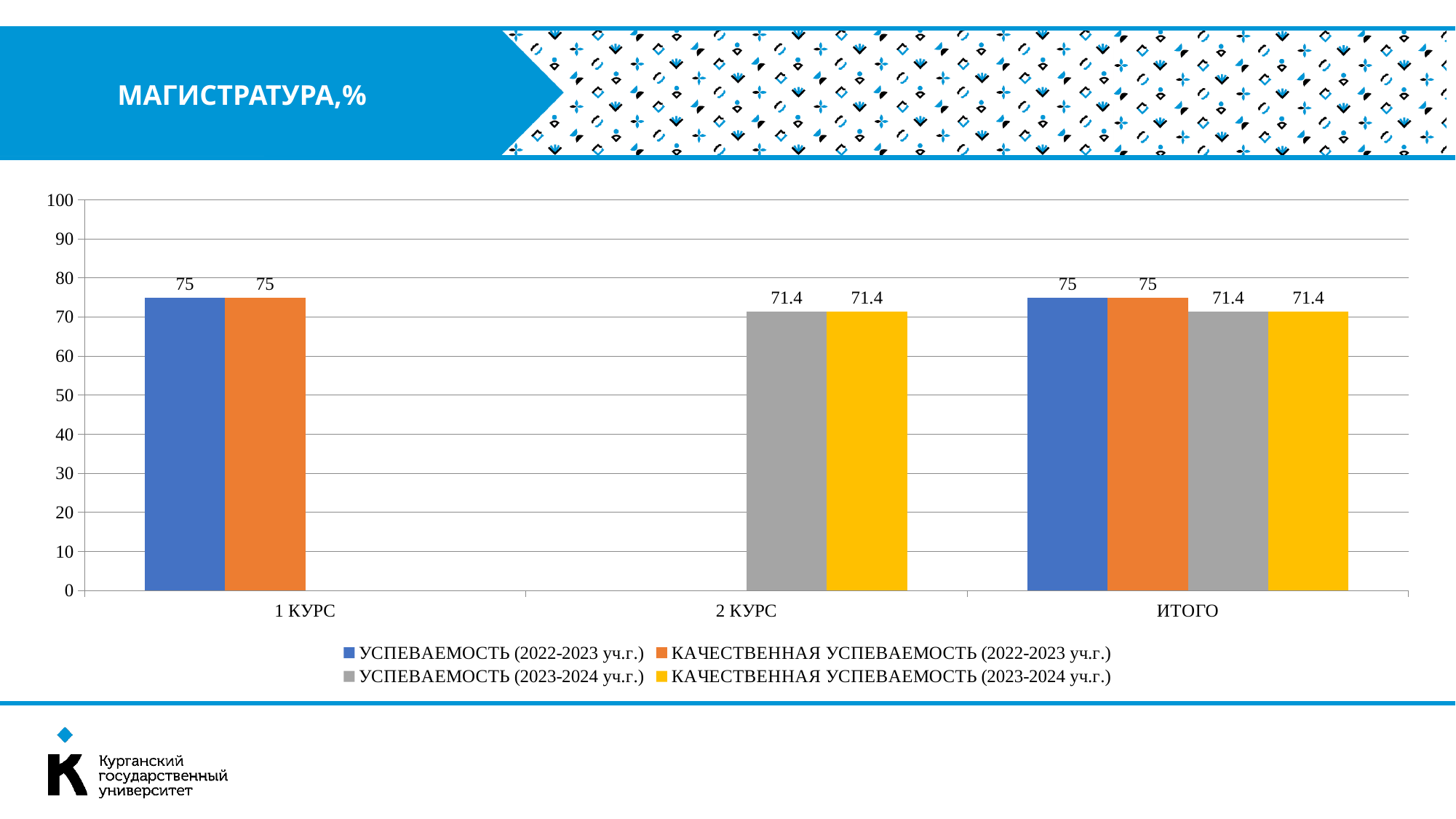
How many series does the legend list? 4 What is the value of КАЧЕСТВЕННАЯ УСПЕВАЕМОСТЬ (2023-2024 уч.г.) for 2 КУРС? 71.4 What is the title of the slide? МАГИСТРАТУРА,% What is the value of УСПЕВАЕМОСТЬ (2022-2023 уч.г.) for 1 КУРС? 75 What is the difference between УСПЕВАЕМОСТЬ (2022-2023 уч.г.) and УСПЕВАЕМОСТЬ (2023-2024 уч.г.) for ИТОГО? 3.6 What is the value of КАЧЕСТВЕННАЯ УСПЕВАЕМОСТЬ (2022-2023 уч.г.) for ИТОГО? 75 Which colour represents КАЧЕСТВЕННАЯ УСПЕВАЕМОСТЬ (2023-2024 уч.г.) in the legend? yellow How many categories are shown on the x axis? 3 What is the value of УСПЕВАЕМОСТЬ (2023-2024 уч.г.) for ИТОГО? 71.4 For ИТОГО, which is larger: КАЧЕСТВЕННАЯ УСПЕВАЕМОСТЬ (2022-2023 уч.г.) or КАЧЕСТВЕННАЯ УСПЕВАЕМОСТЬ (2023-2024 уч.г.)? КАЧЕСТВЕННАЯ УСПЕВАЕМОСТЬ (2022-2023 уч.г.) Is the value of УСПЕВАЕМОСТЬ (2023-2024 уч.г.) for 2 КУРС greater or less than 80? less What kind of chart is shown on the slide? bar chart